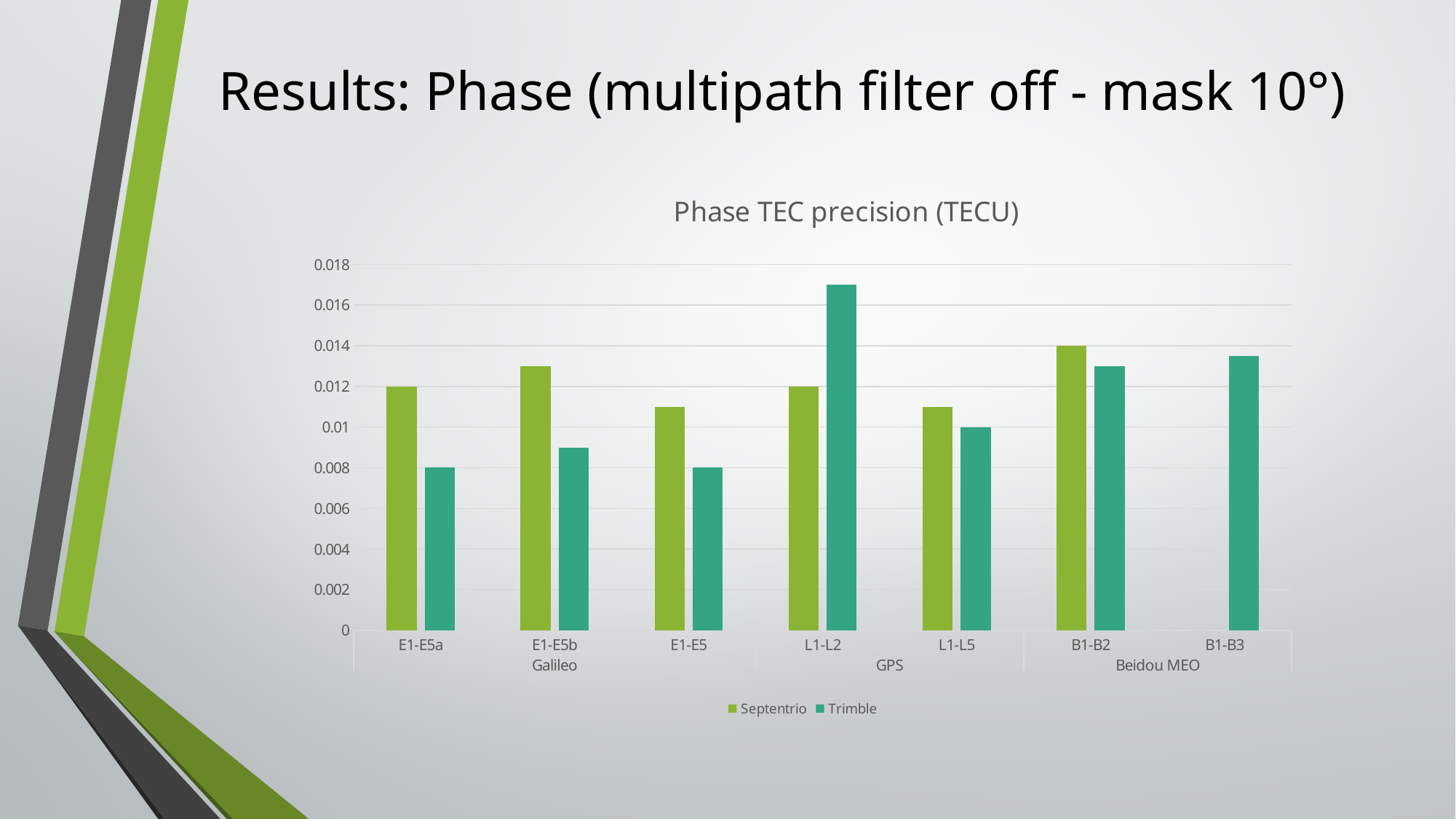
What is the title of the chart? Phase TEC precision (TECU) How many series does the legend list? 2 What is the Septentrio value for E1-E5a? 0.012 What is the Septentrio value for B1-B2? 0.014 For L1-L2, which series has the larger value, Septentrio or Trimble? Trimble How many signal categories are shown along the x axis? 7 What type of chart is shown on the slide? bar chart What is the Trimble value for L1-L5? 0.01 Is the Trimble value for B1-B3 greater or less than 0.012? greater Which category has the highest Septentrio value? B1-B2 Which category has the highest Trimble value? L1-L2 What is the Trimble value for E1-E5a? 0.008